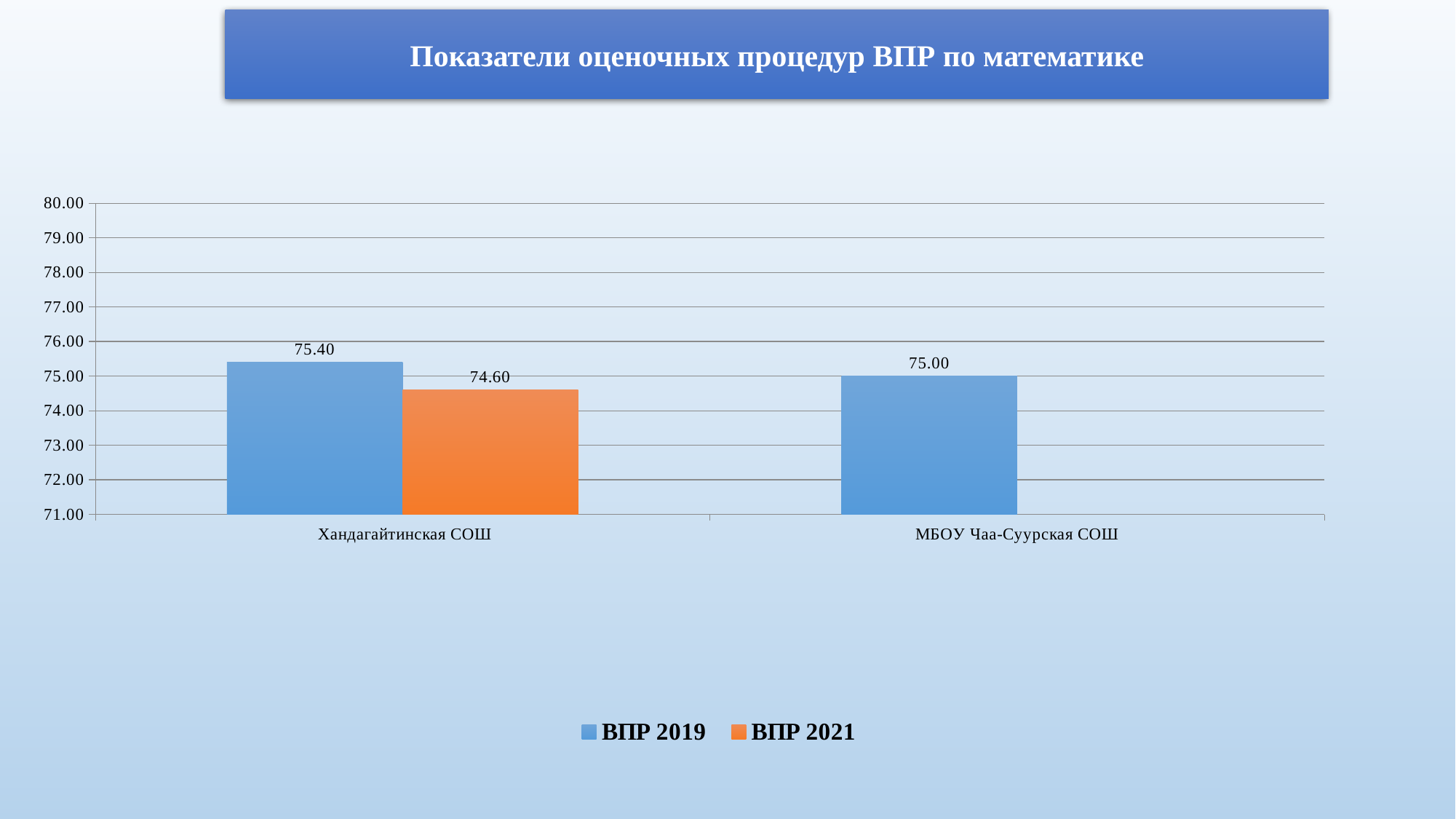
What is the title of the slide? Показатели оценочных процедур ВПР по математике What is the ВПР 2019 value for МБОУ Чаа-Суурская СОШ? 75.00 Is the ВПР 2021 value for Хандагайтинская СОШ greater or less than 75.00? less Which school has the highest ВПР 2019 value? Хандагайтинская СОШ Which is larger: the ВПР 2019 value for Хандагайтинская СОШ or the ВПР 2021 value for Хандагайтинская СОШ? ВПР 2019 What is the ВПР 2019 value for Хандагайтинская СОШ? 75.40 What is the difference between the ВПР 2019 and ВПР 2021 values for Хандагайтинская СОШ? 0.80 How many series does the legend list? 2 What kind of chart is shown on the slide? bar chart What is the ВПР 2021 value for Хандагайтинская СОШ? 74.60 How many schools (categories) are shown on the x axis? 2 What is the difference between the ВПР 2019 values for Хандагайтинская СОШ and МБОУ Чаа-Суурская СОШ? 0.40